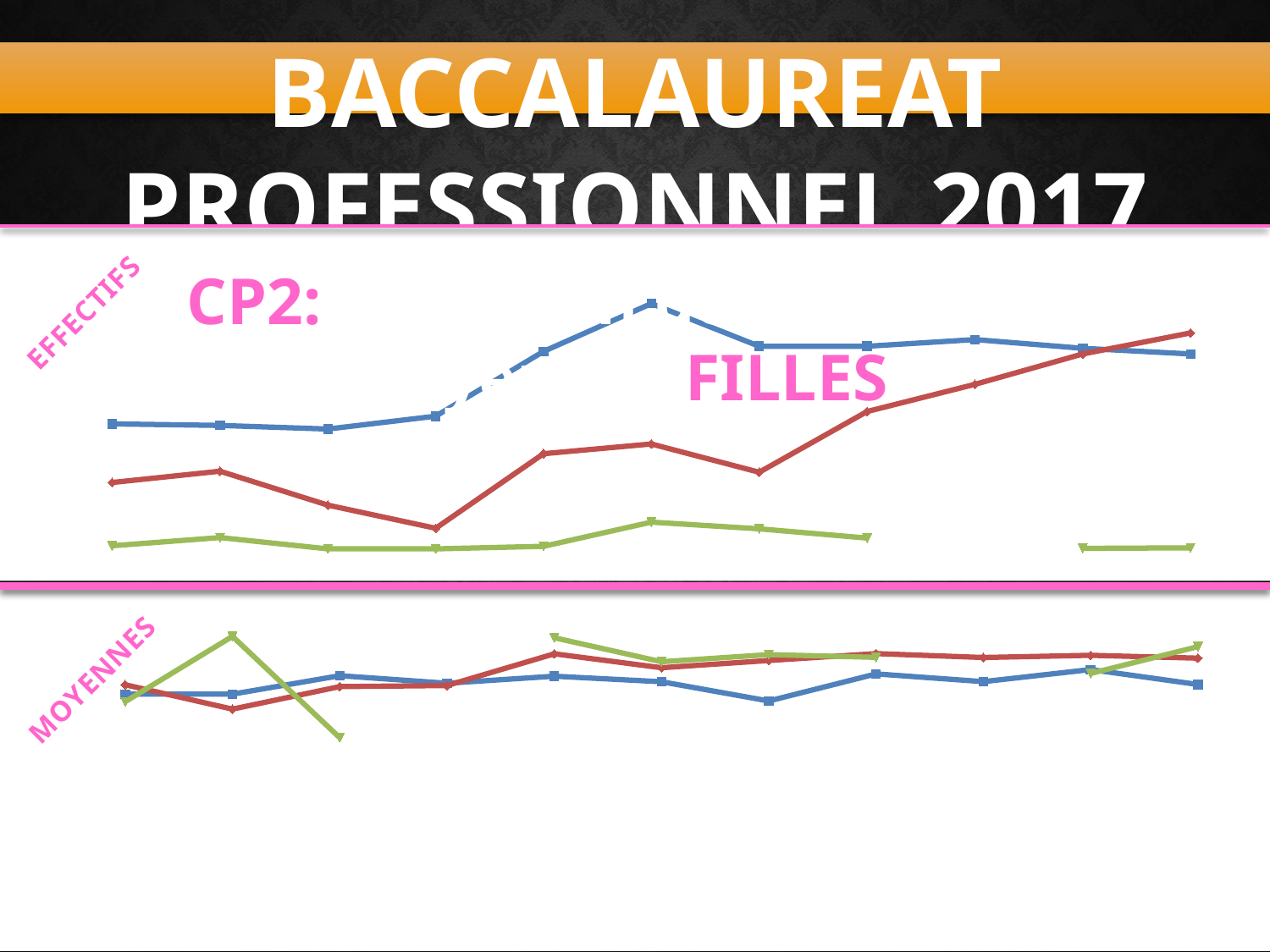
What kind of chart is the top chart labelled EFFECTIFS? line chart On the top chart labelled EFFECTIFS, which line is the lowest across the whole chart? the green line On the top chart labelled EFFECTIFS, at the leftmost point, is the blue line above or below the red line? above What label is written in pink next to the bottom chart? MOYENNES On the top chart labelled EFFECTIFS, which line is highest at the rightmost point? the red line How many lines are plotted on the top chart labelled EFFECTIFS? 3 On the top chart labelled EFFECTIFS, which line reaches the highest point on the chart? the blue line What label is written in pink next to the top chart? EFFECTIFS How many lines are plotted on the bottom chart labelled MOYENNES? 3 What kind of chart is the bottom chart labelled MOYENNES? line chart On the top chart labelled EFFECTIFS, does the red line overall rise or fall from left to right? rise How many data points does the blue line have on the top chart labelled EFFECTIFS? 11